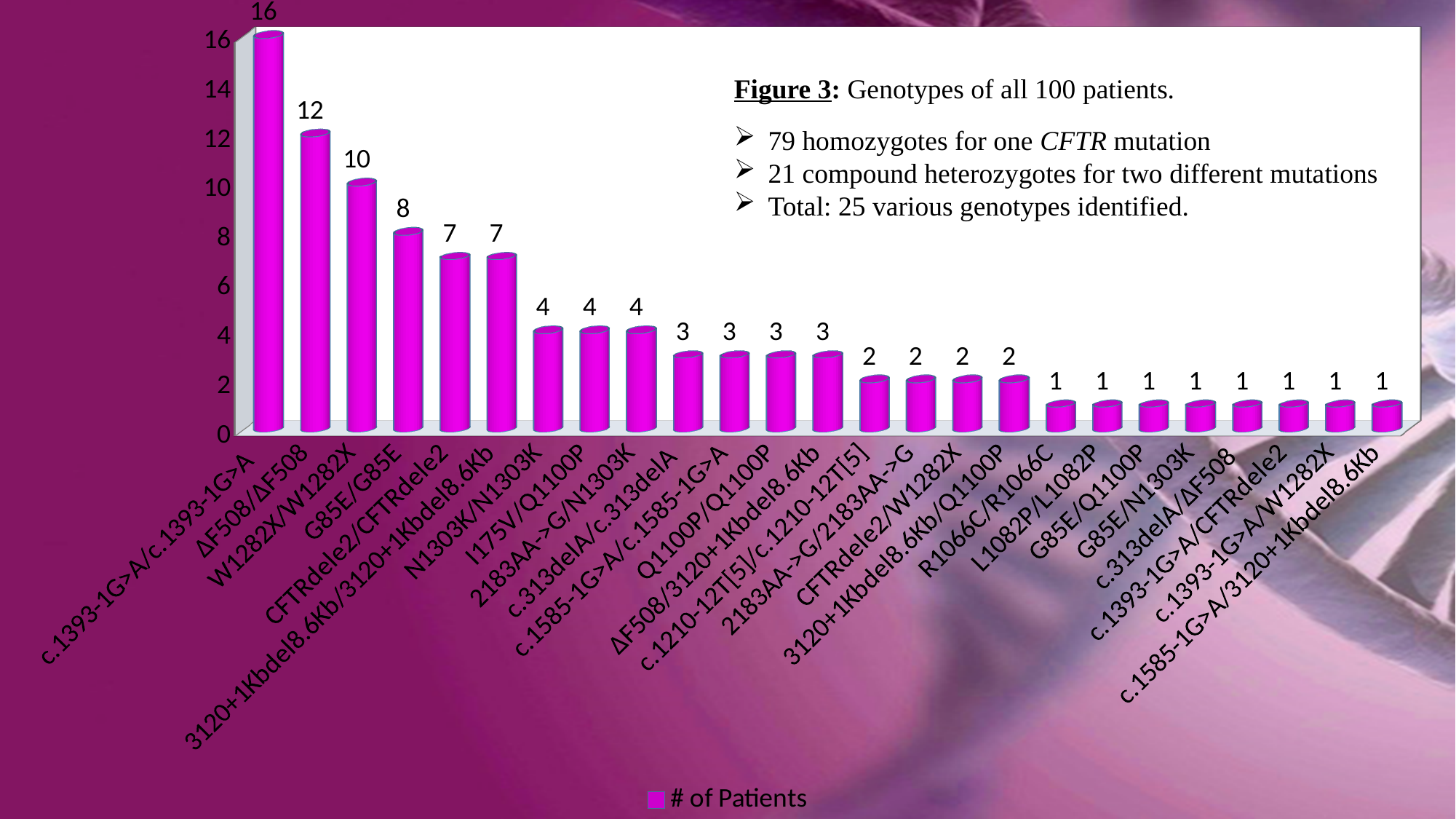
How many patients have the CFTRdele2/W1282X genotype? 2 How many patients have the ΔF508/ΔF508 genotype? 12 Which has more patients, N1303K/N1303K or c.313delA/c.313delA? N1303K/N1303K Which genotype has the highest number of patients? c.1393-1G>A/c.1393-1G>A Do the values rise or fall from left to right along the x axis? fall What is the legend entry for the series? # of Patients How many patients have the G85E/G85E genotype? 8 What is the difference in number of patients between c.1393-1G>A/c.1393-1G>A and ΔF508/ΔF508? 4 How many genotype categories are shown on the x axis? 25 How many series does the legend list? 1 What kind of chart is shown on the slide? bar chart What is the value for W1282X/W1282X? 10